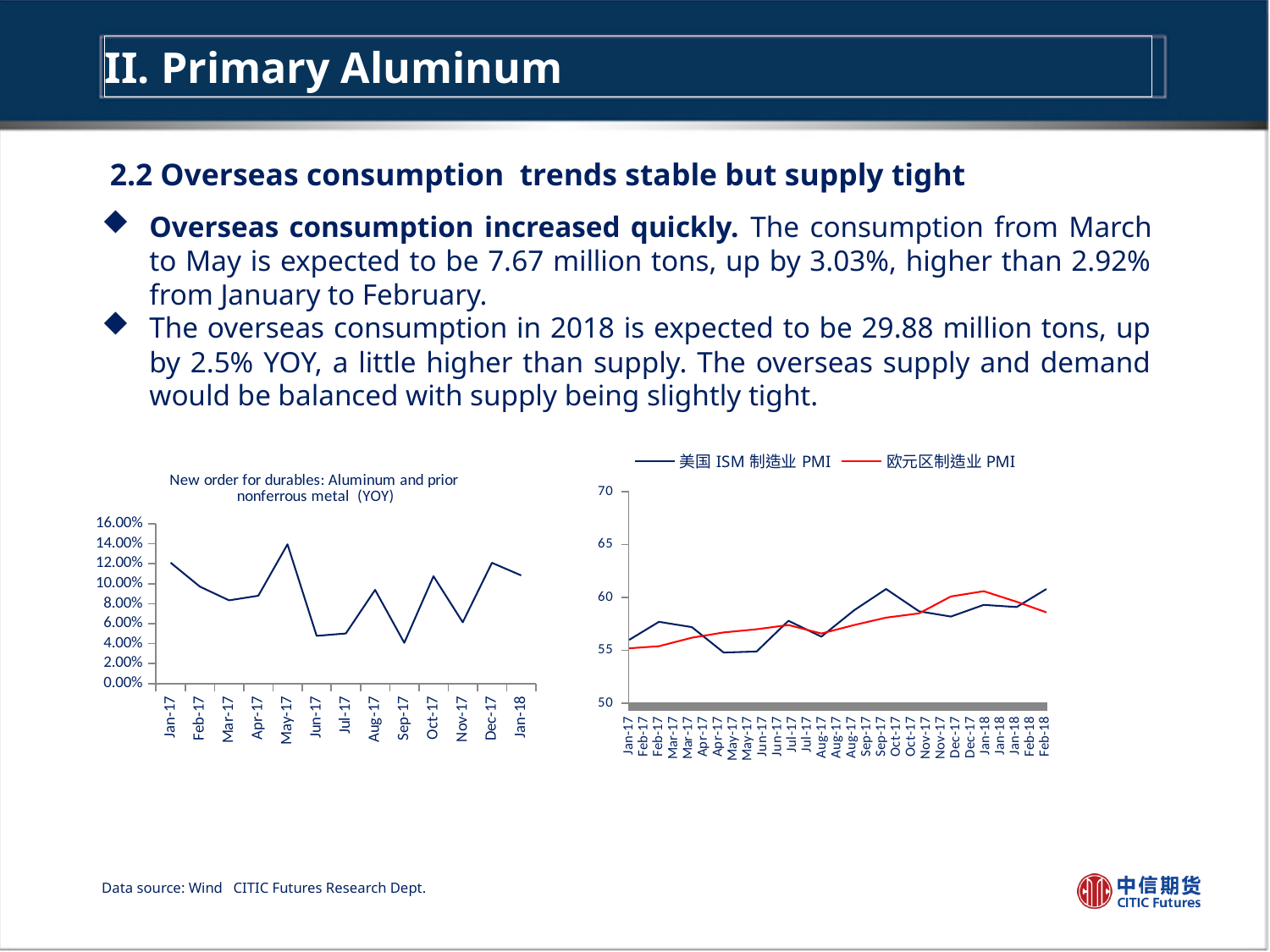
On the left chart (New order for durables), which month has the lowest value? Sep-17 On the right chart (PMI chart), does the 欧元区制造业 PMI series generally rise or fall from Jan-17 to Jan-18? Rise On the left chart (New order for durables), which month has the highest value? May-17 On the left chart (New order for durables), is the value for May-17 greater or less than 12.00%? greater On the right chart (PMI chart), what colour is the line for 欧元区制造业 PMI? Red How many series does the legend of the right chart (PMI chart) list? 2 On the right chart (PMI chart), is the 欧元区制造业 PMI value for Jan-17 greater or less than 60? less On the left chart (New order for durables), is the value for Jan-17 greater or less than 10.00%? greater How many monthly data points are plotted on the left chart (New order for durables)? 13 On the right chart (PMI chart), which series has the higher value in Feb-18, 美国 ISM 制造业 PMI or 欧元区制造业 PMI? 美国 ISM 制造业 PMI What kind of chart is the left chart titled "New order for durables: Aluminum and prior nonferrous metal (YOY)"? Line chart